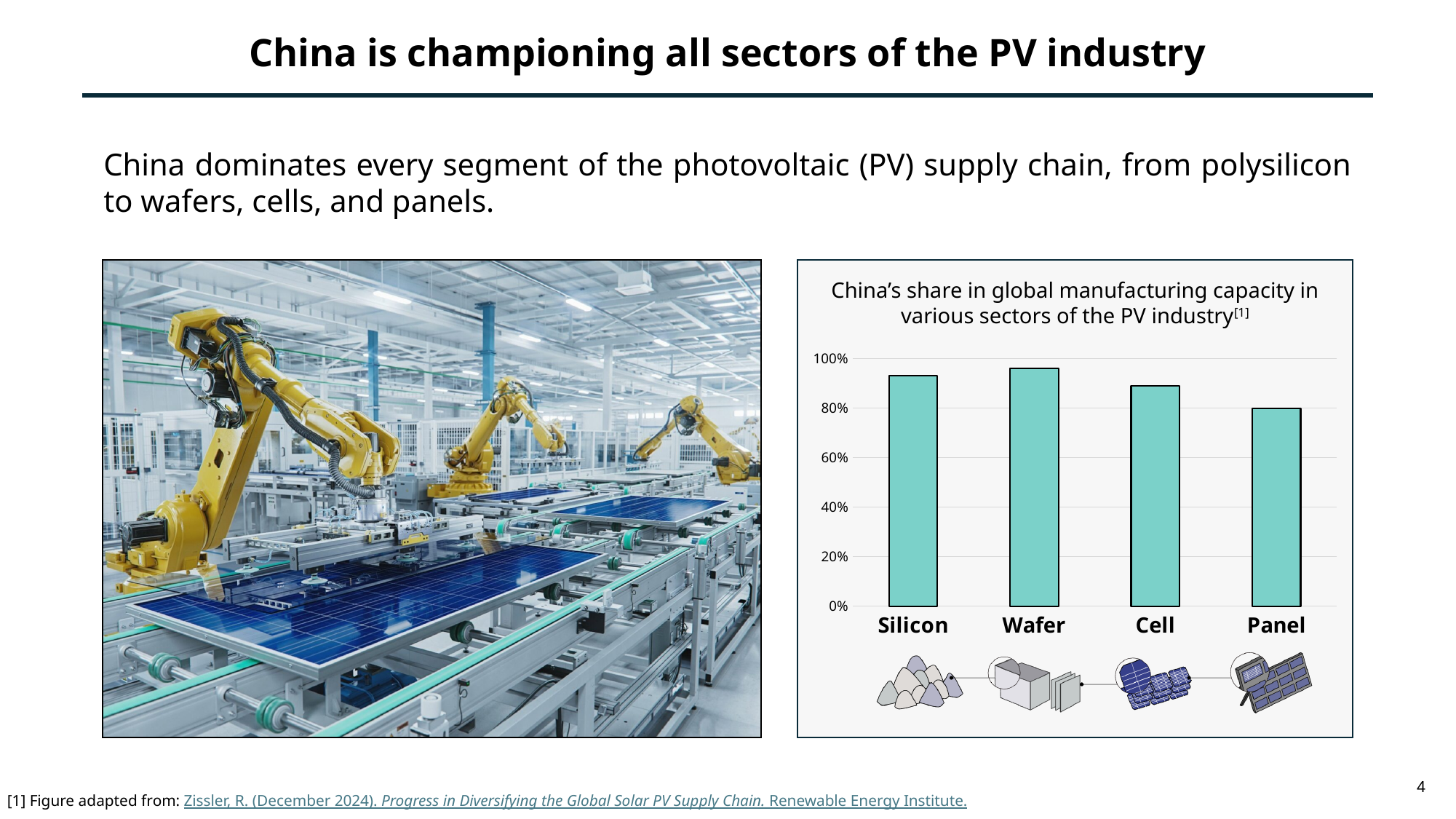
How many sectors of the PV industry are shown as categories in the chart? 4 Is the value for Silicon greater or less than 80%? greater What is China's share in global manufacturing capacity for Panel? 80% What is the highest value shown on the chart's vertical axis? 100% Is the value for Wafer greater or less than 100%? less What is the title of the chart? China's share in global manufacturing capacity in various sectors of the PV industry What kind of chart is shown on the slide? bar chart Which has a larger value, Silicon or Cell? Silicon Which sector has the highest value for China's share in global manufacturing capacity? Wafer Which sector has the lowest value for China's share in global manufacturing capacity? Panel Is the value for Cell greater or less than 80%? greater Which has a larger value, Wafer or Panel? Wafer